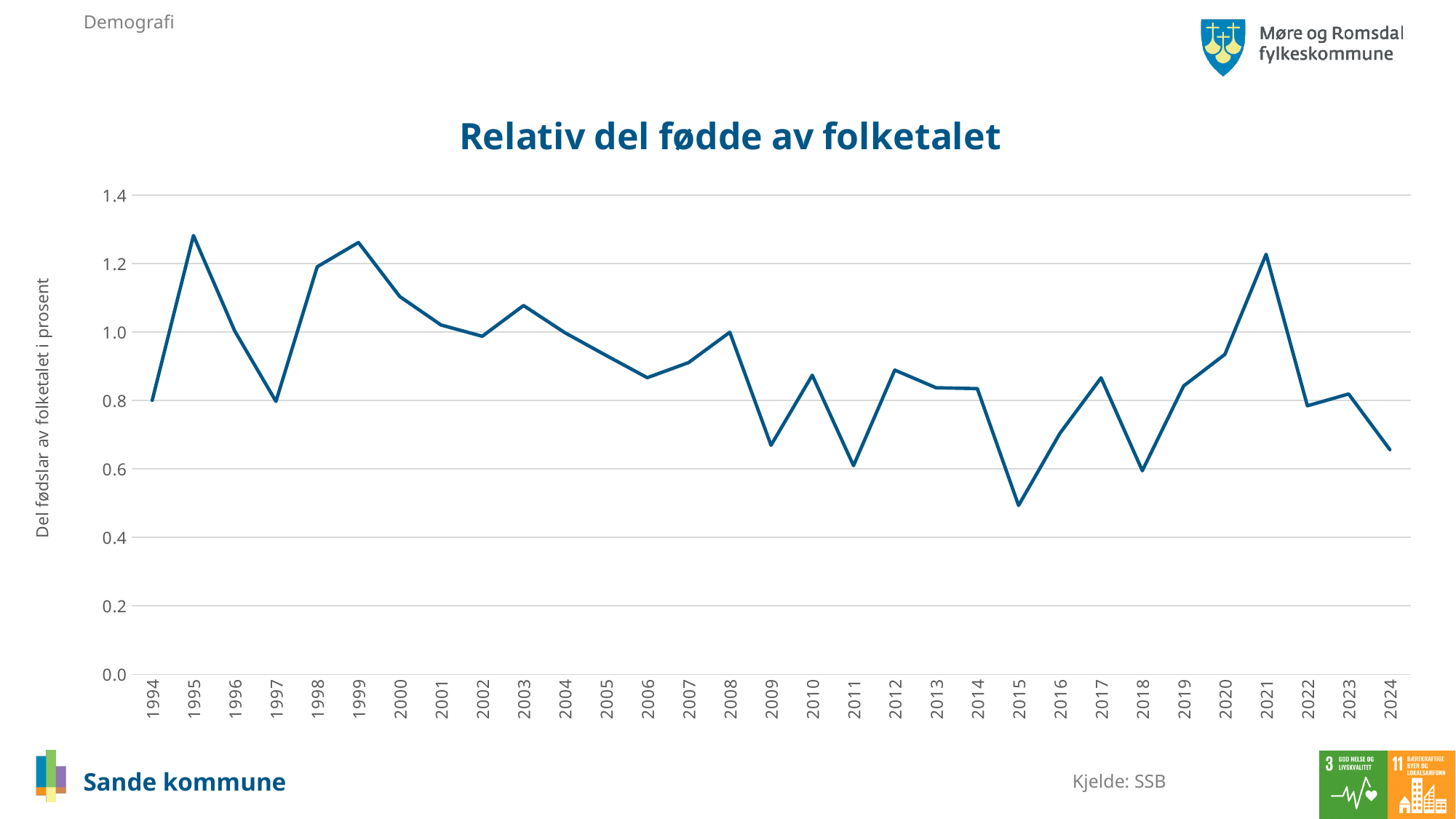
Which year has the larger value, 2021 or 2015? 2021 Is the value for 1998 greater or less than 1.0? greater Is the value in 2024 higher or lower than the value in 1994? lower Which year has the larger value, 2008 or 2009? 2008 What kind of chart is shown on the slide? line chart Is the value for 2015 greater or less than 0.6? less How many years are plotted along the x axis of the chart? 31 What is the label on the vertical axis of the chart? Del fødslar av folketalet i prosent Is the value for 2021 greater or less than 1.2? greater Which year has the lowest value in the chart? 2015 What is the title of the chart? Relativ del fødde av folketalet